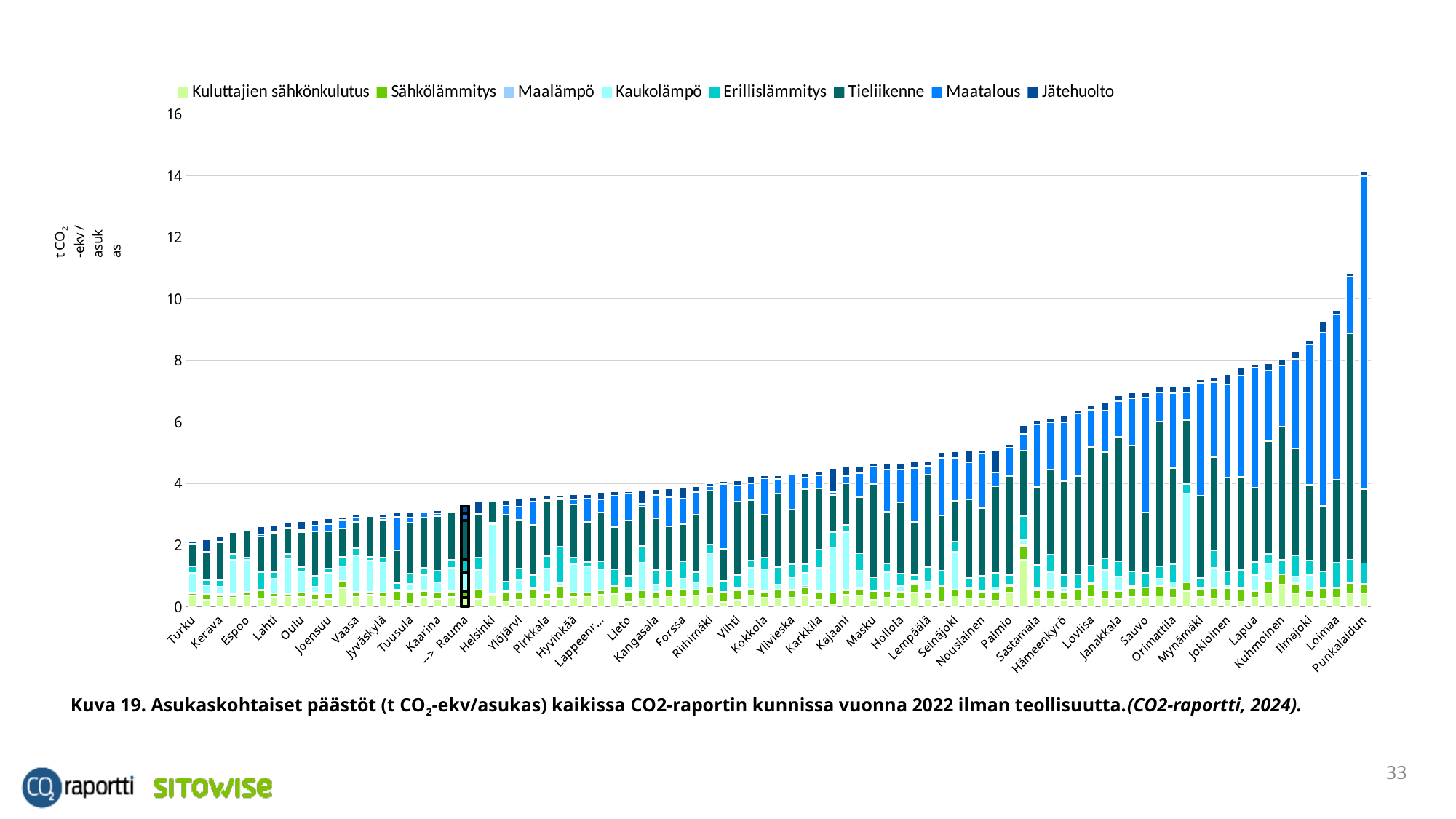
Which municipality has the highest total emissions per inhabitant in the chart? Punkalaidun Which series in the legend is shown in the lightest green colour? Kuluttajien sähkönkulutus Is the total value for Sastamala greater or less than 5? greater Do the total bar heights generally rise or fall moving from left to right along the x axis? Rise What is the last series listed in the legend? Jätehuolto Is the total value for Punkalaidun greater or less than 12? greater What kind of chart is shown on the slide? Stacked bar chart Is the total value for Turku greater or less than 4? less How many series does the legend list? 8 Which has a larger total value, Loimaa or Helsinki? Loimaa